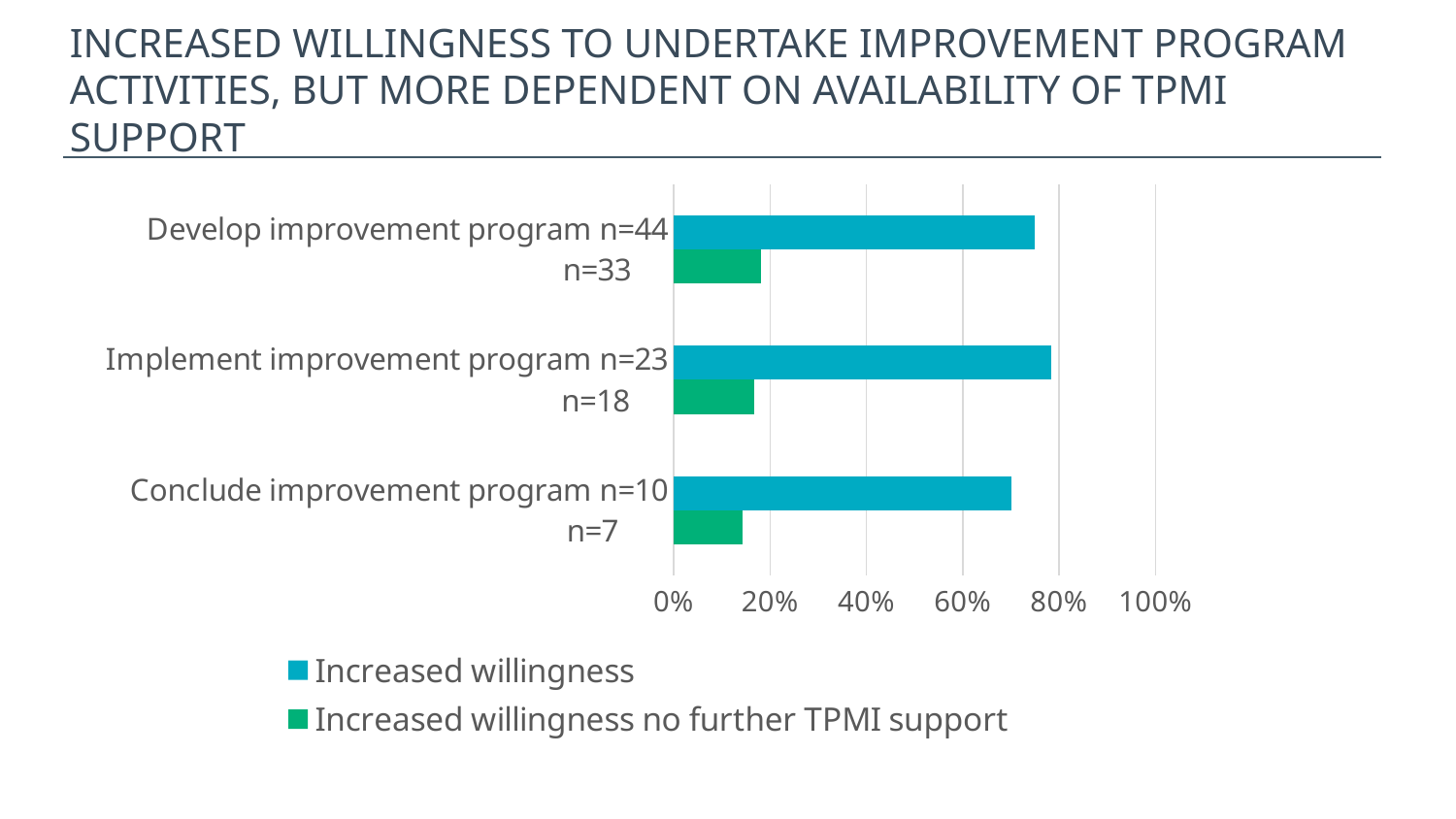
How many improvement program activities (categories) are shown on the chart? 3 Is the 'Increased willingness' value for 'Conclude improvement program' greater or less than 80%? less Is the 'Increased willingness' value for 'Implement improvement program' greater or less than 60%? greater What is the second legend entry on the chart? Increased willingness no further TPMI support How many series does the legend list? 2 Is the 'Increased willingness' value for 'Develop improvement program' greater or less than 60%? greater For 'Increased willingness', which is larger: 'Develop improvement program' or 'Conclude improvement program'? Develop improvement program What kind of chart is shown on the slide? bar chart For 'Develop improvement program', which series has the larger value: 'Increased willingness' or 'Increased willingness no further TPMI support'? Increased willingness Which category has the lowest value for the 'Increased willingness' series? Conclude improvement program